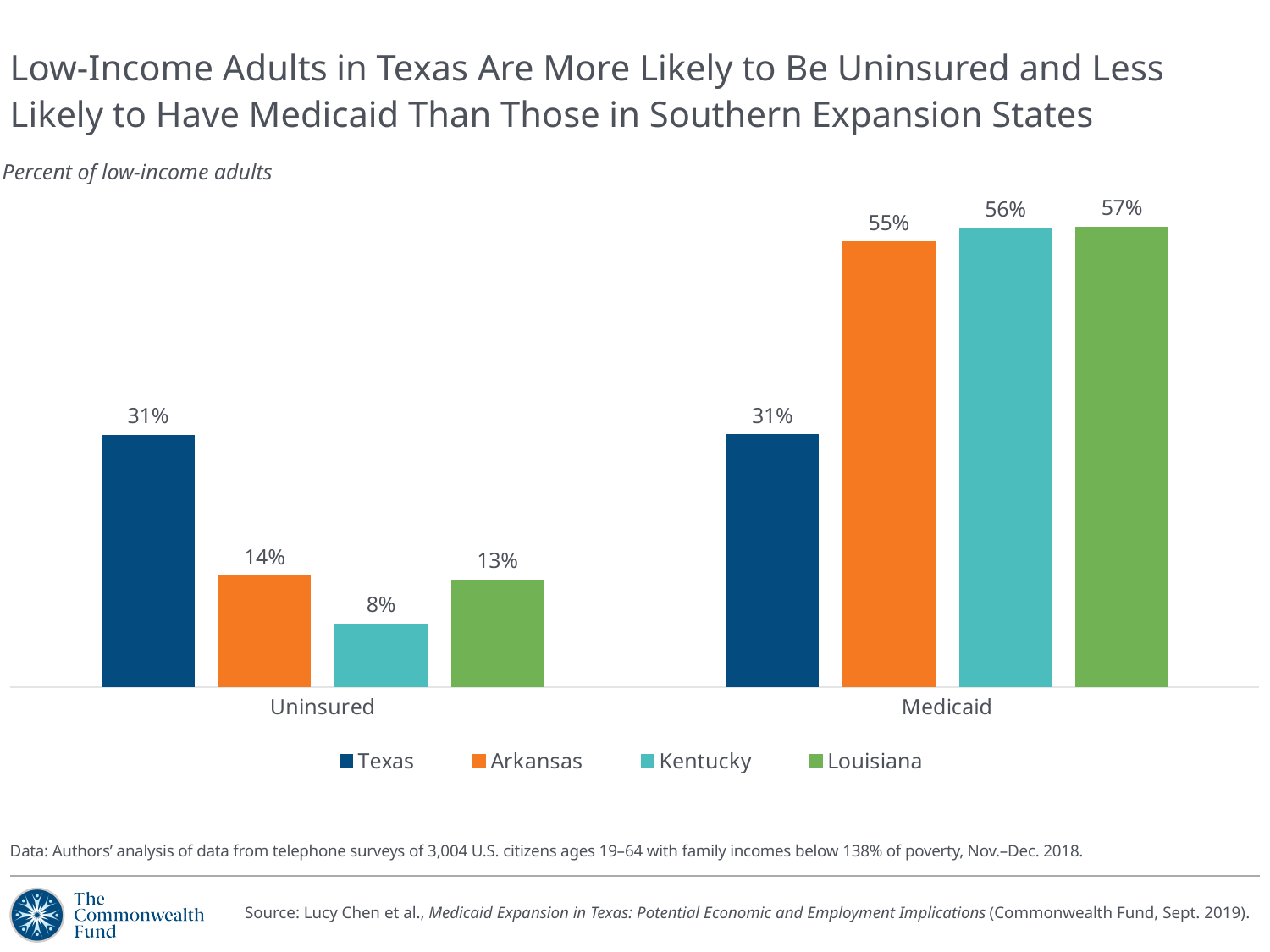
Which is larger: the uninsured rate in Arkansas or the uninsured rate in Louisiana? Arkansas Which state has the lowest uninsured rate among low-income adults? Kentucky Which state has the highest Medicaid coverage rate among low-income adults? Louisiana What is the difference between the Medicaid rate in Arkansas and the Medicaid rate in Texas? 24 percentage points What is the difference between the uninsured rate in Texas and the uninsured rate in Arkansas? 17 percentage points What percent of low-income adults in Texas are uninsured? 31% What kind of chart is shown on the slide? Bar chart How many categories are shown on the x axis? 2 How many states does the legend list? 4 What is the uninsured rate for low-income adults in Louisiana? 13% What percent of low-income adults in Kentucky have Medicaid? 56% Which colour represents Texas in the chart? Dark blue